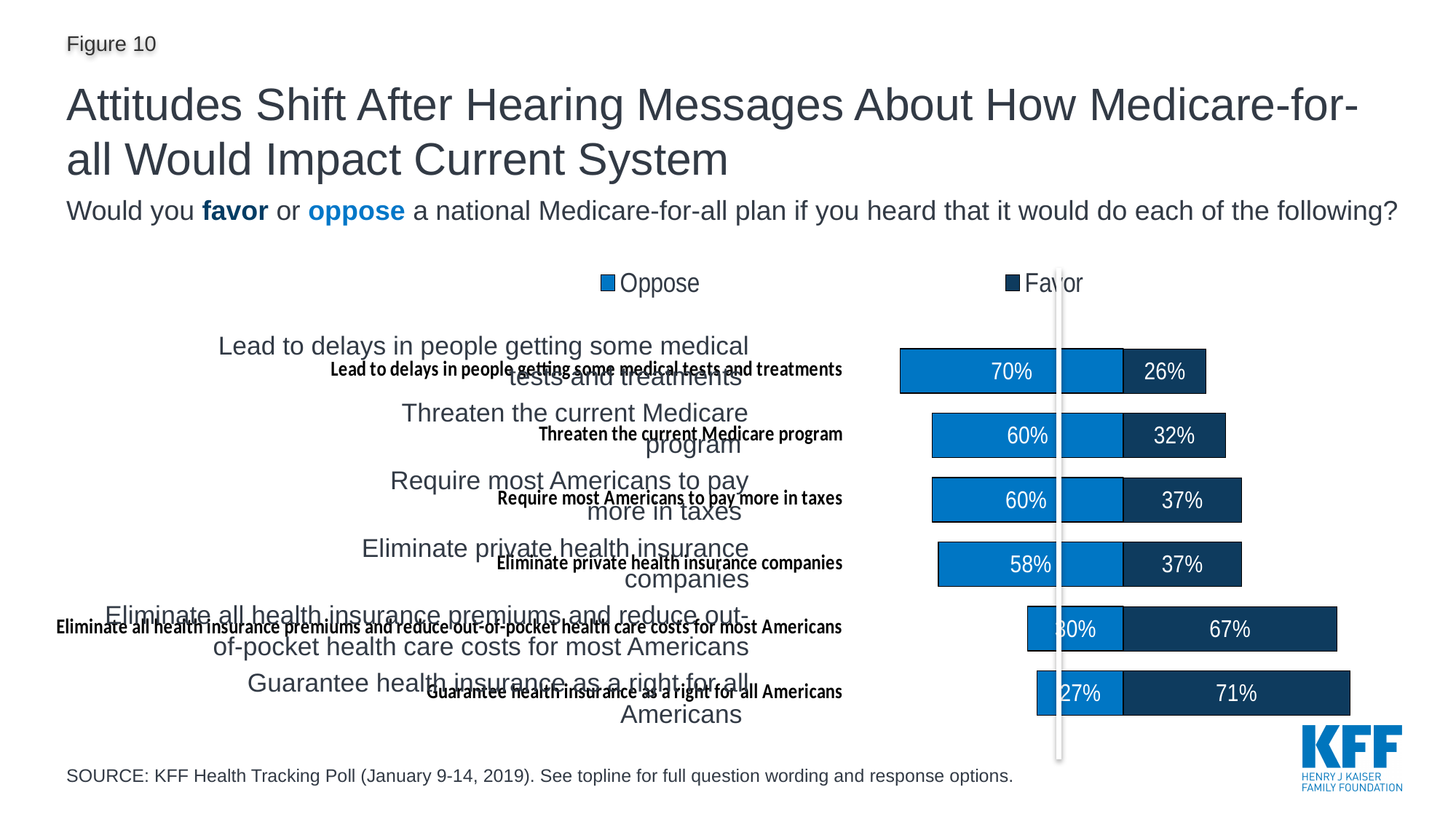
What is the Oppose value for "Eliminate private health insurance companies"? 58% Which category has the lowest Favor value? Lead to delays in people getting some medical tests and treatments What is the Favor value for "Eliminate all health insurance premiums and reduce out-of-pocket health care costs for most Americans"? 67% For "Require most Americans to pay more in taxes", which is larger, the Oppose value or the Favor value? Oppose What is the Favor value for "Guarantee health insurance as a right for all Americans"? 71% How many series does the legend list? 2 What kind of chart is shown on the slide? bar chart What is the Oppose value for "Lead to delays in people getting some medical tests and treatments"? 70% What is the difference between the Oppose and Favor values for "Threaten the current Medicare program"? 28 percentage points How many categories (messages) are plotted in the chart? 6 What are the two series named in the legend? Oppose and Favor Which category has the highest Favor value? Guarantee health insurance as a right for all Americans